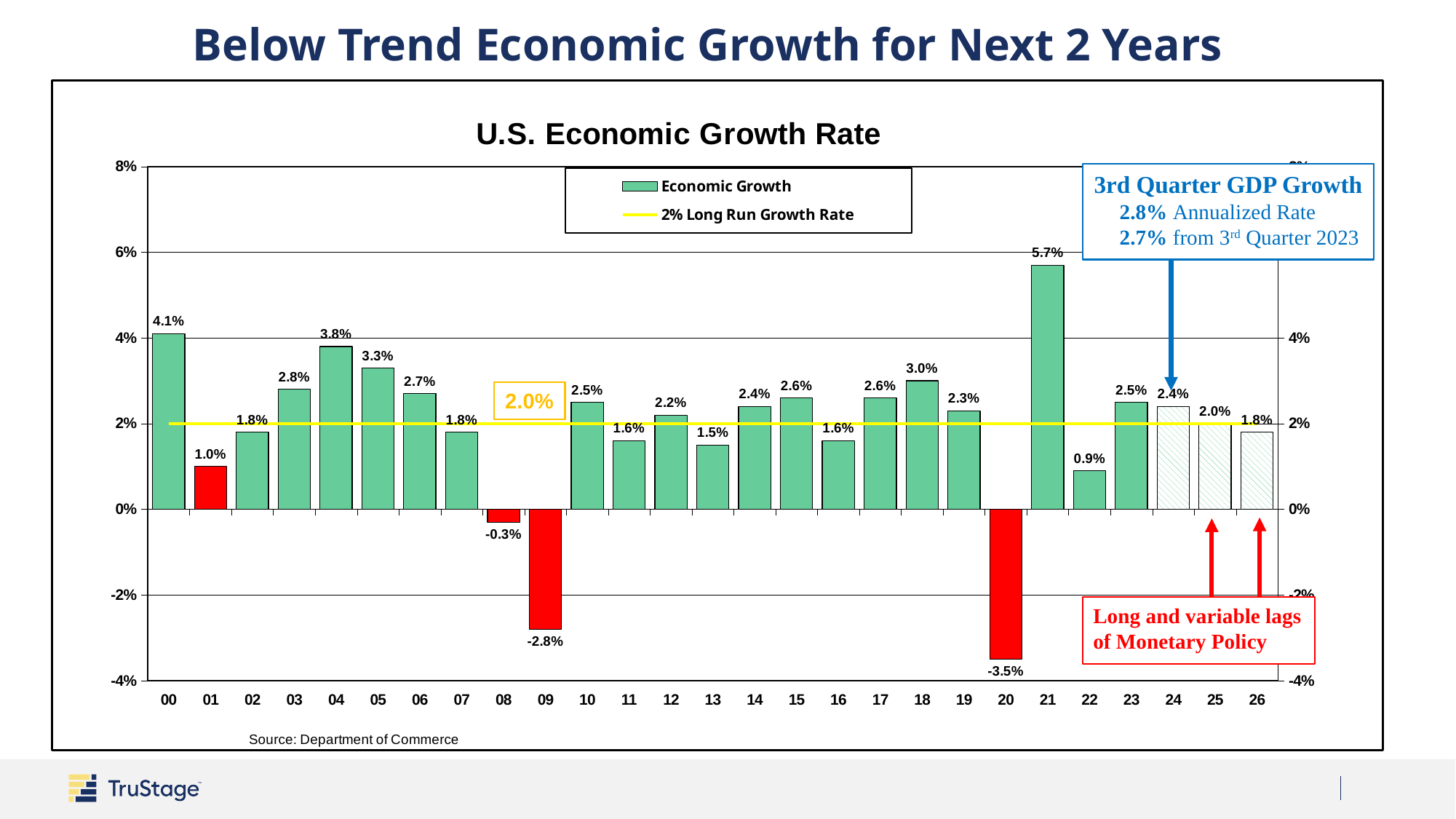
Which year had a higher growth rate, 2004 or 2005? 2004 What is the title of the chart? U.S. Economic Growth Rate What is the economic growth rate shown for 2021? 5.7% Which year has the highest economic growth rate on the chart? 21 How many series does the legend list? 2 Do the growth rates rise or fall from 2023 to 2026? Fall What is the projected economic growth rate for 2025? 2.0% What is the difference between the growth rate in 2021 and the growth rate in 2022? 4.8% How many years are shown on the x axis of the chart? 27 What is the economic growth rate shown for 2009? -2.8% Which year has the lowest economic growth rate on the chart? 20 What kind of chart is used to show the U.S. Economic Growth Rate? Bar chart